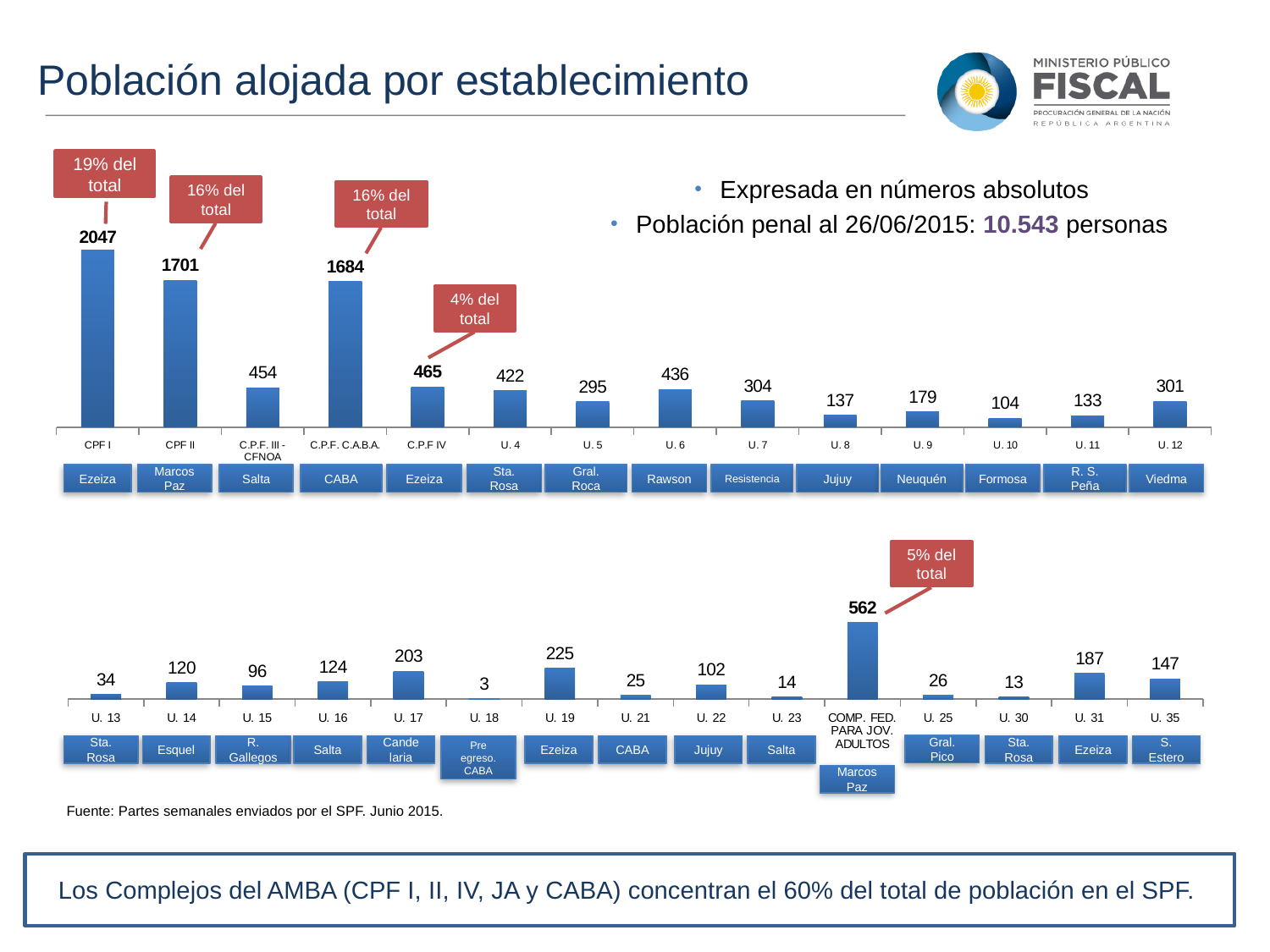
In the bottom chart, how many establishments are shown? 15 In the bottom chart, which establishment has the highest value? COMP. FED. PARA JOV. ADULTOS In the top chart, what is the value for U. 9? 179 In the top chart, what is the difference between CPF II and C.P.F. C.A.B.A.? 17 In the bottom chart, what is the value for U. 19? 225 In the bottom chart, which establishment has the lowest value? U. 18 In the bottom chart, which is larger, U. 31 or U. 35? U. 31 In the top chart, which establishment has the highest value? CPF I In the top chart, how many establishments are shown? 14 In the top chart, which establishment has the lowest value? U. 10 In the top chart, what is the value for CPF I? 2047 What type of chart is used on this slide? Bar chart